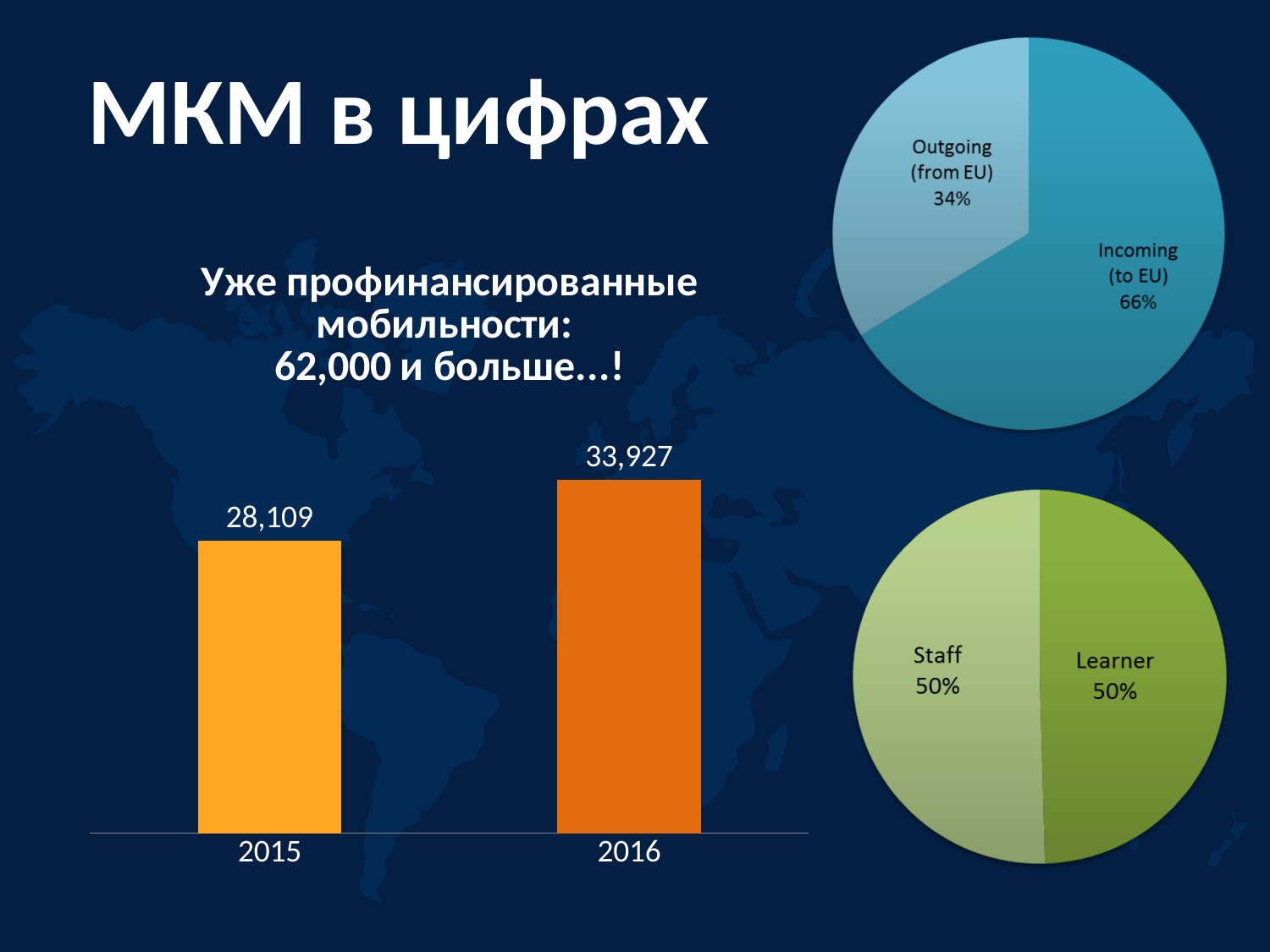
In the pie chart at the top right, which slice is larger, Incoming (to EU) or Outgoing (from EU)? Incoming (to EU) In the pie chart at the top right, what share is Incoming (to EU)? 66% In the bar chart at the bottom left, how many bars are shown? 2 In the bar chart at the bottom left, what is the value for 2016? 33,927 What kind of chart is shown at the bottom left of the slide? bar chart In the bar chart at the bottom left, which year has the higher value? 2016 In the bar chart at the bottom left, what is the value for 2015? 28,109 In the bar chart at the bottom left, what is the difference between the 2016 and 2015 values? 5,818 In the pie chart at the bottom right, what share is Staff? 50% In the pie chart at the top right, what share is Outgoing (from EU)? 34% In the bar chart at the bottom left, do the values rise or fall from 2015 to 2016? rise In the pie chart at the bottom right, how many slices are there? 2